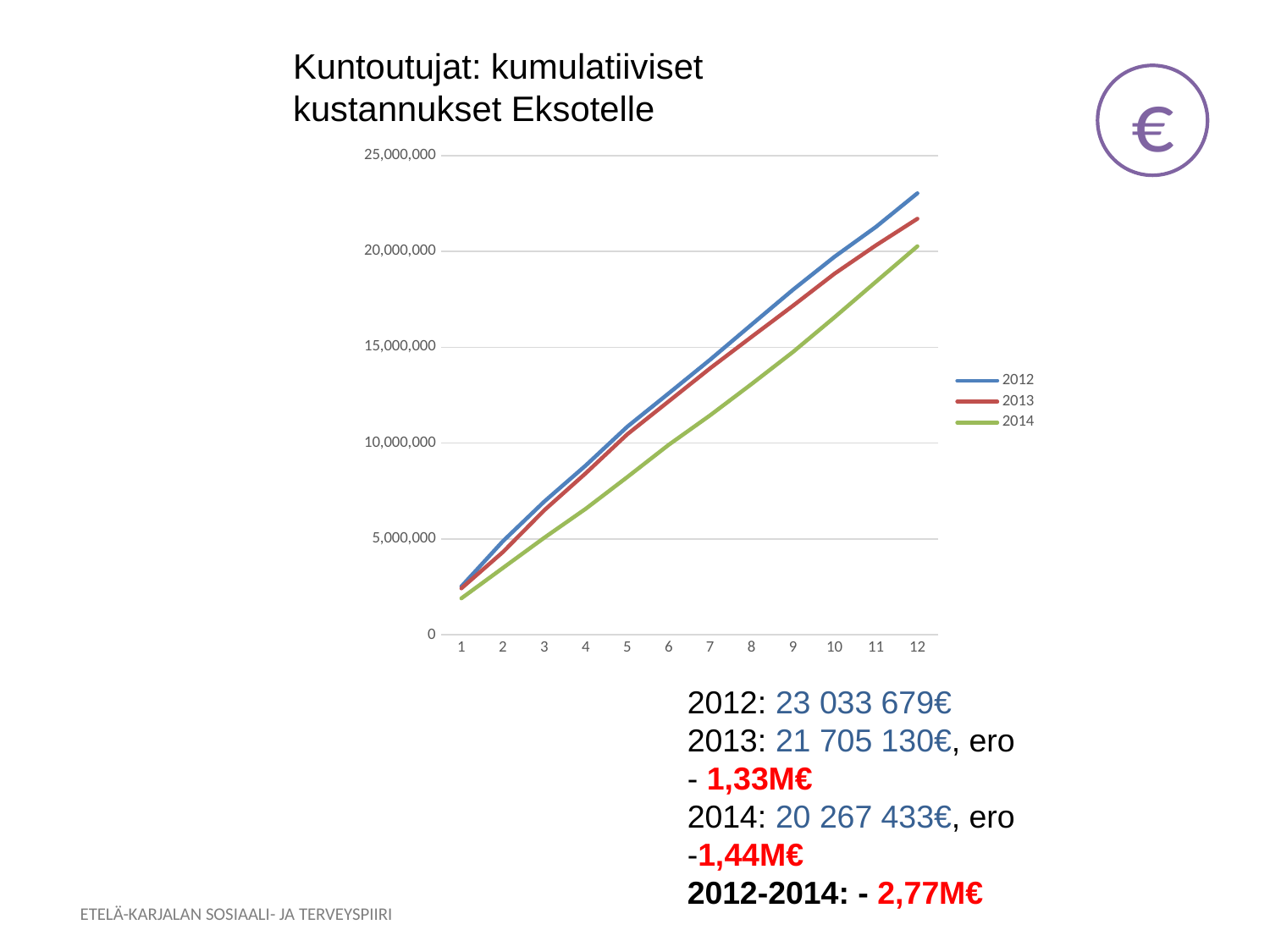
What kind of chart is shown on the slide? line chart According to the text on the slide, what is the cumulative cost for 2013? 21 705 130€ How many series does the legend list? 3 Do the values of the 2014 series rise or fall along the x axis? rise Is the value of the 2012 series at point 12 greater or less than 25,000,000? less Which series has the highest value at point 12? 2012 Is the value of the 2014 series at point 12 greater or less than 20,000,000? greater Which series has the lowest value at point 12? 2014 At point 8, which series is larger, 2012 or 2014? 2012 How many points are on the x axis of the chart? 12 What is the title of the chart on the slide? Kuntoutujat: kumulatiiviset kustannukset Eksotelle Is the value of the 2013 series at point 6 greater or less than 15,000,000? less